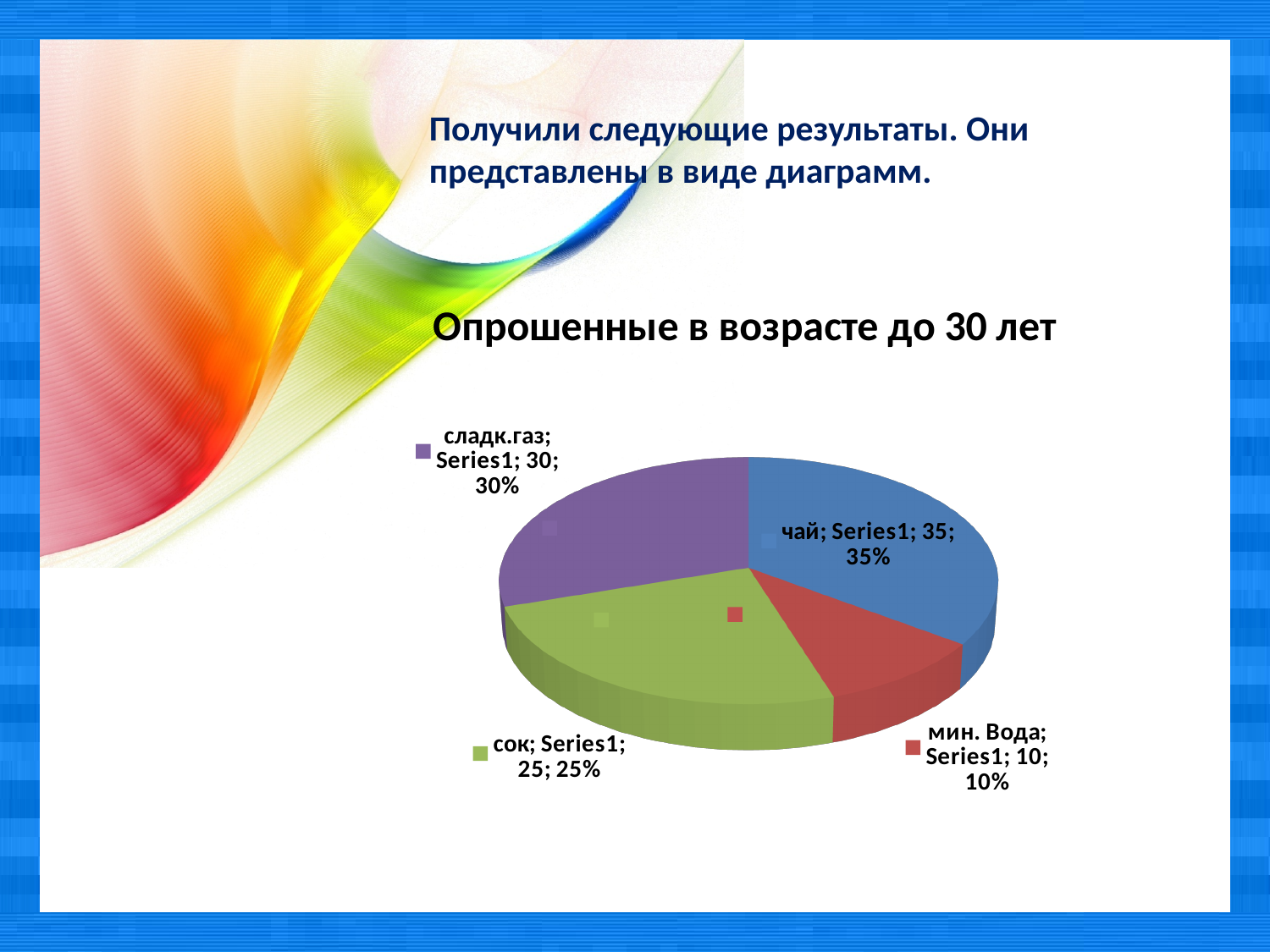
What share of the pie does сок represent? 25% What is the difference between the values for чай and мин. Вода? 25 What is the value for сладк.газ? 30 What is the value for чай? 35 Which category has the smallest slice? мин. Вода What type of chart is shown on the slide? Pie chart What is the title of the chart? Опрошенные в возрасте до 30 лет What is the value for мин. Вода? 10 Which category has the largest slice? чай Which is larger, the value for сладк.газ or the value for сок? сладк.газ What colour is the slice for сок? Green How many slices does the pie chart have? 4